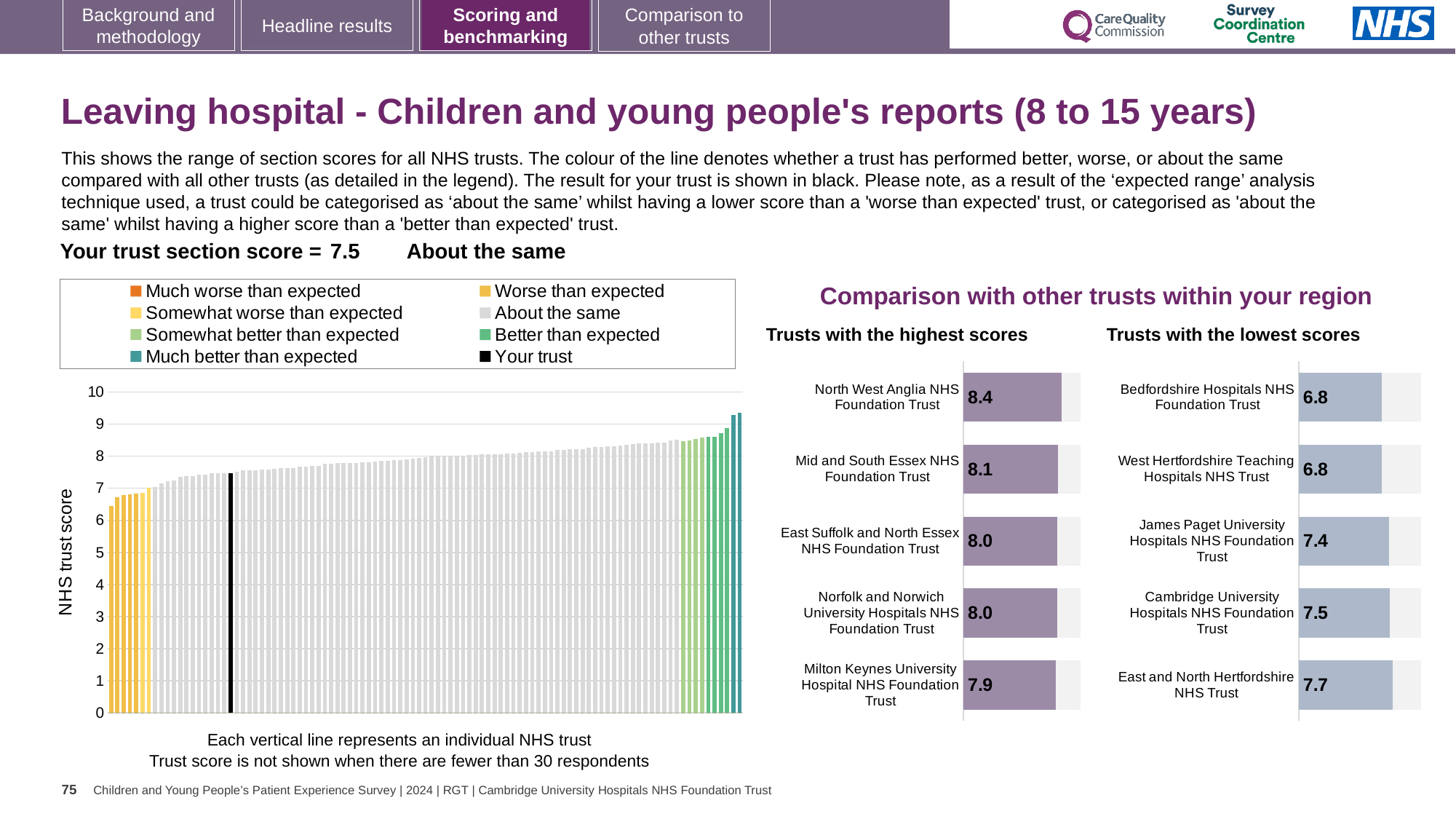
In the 'Trusts with the lowest scores' chart, which has the larger score: James Paget University Hospitals NHS Foundation Trust or Cambridge University Hospitals NHS Foundation Trust? Cambridge University Hospitals NHS Foundation Trust In the main 'NHS trust score' chart on the left, is the value of the tallest bar greater or less than 9? greater In the 'Trusts with the lowest scores' chart, what is the difference between the scores of East and North Hertfordshire NHS Trust and Bedfordshire Hospitals NHS Foundation Trust? 0.9 In the 'Trusts with the highest scores' chart, what is the score for North West Anglia NHS Foundation Trust? 8.4 In the 'Trusts with the highest scores' chart, what is the difference between the scores of North West Anglia NHS Foundation Trust and Milton Keynes University Hospital NHS Foundation Trust? 0.5 What kind of chart is the main 'NHS trust score' chart on the left? Bar chart In the 'Trusts with the lowest scores' chart, what is the score for James Paget University Hospitals NHS Foundation Trust? 7.4 In the 'Trusts with the highest scores' chart, what is the score for Milton Keynes University Hospital NHS Foundation Trust? 7.9 How many entries does the legend of the main 'NHS trust score' chart list? 8 In the 'Trusts with the lowest scores' chart, which trust has the highest score? East and North Hertfordshire NHS Trust In the 'Trusts with the highest scores' chart, which trust has the lowest score? Milton Keynes University Hospital NHS Foundation Trust In the 'Trusts with the highest scores' chart, how many trusts are listed? 5